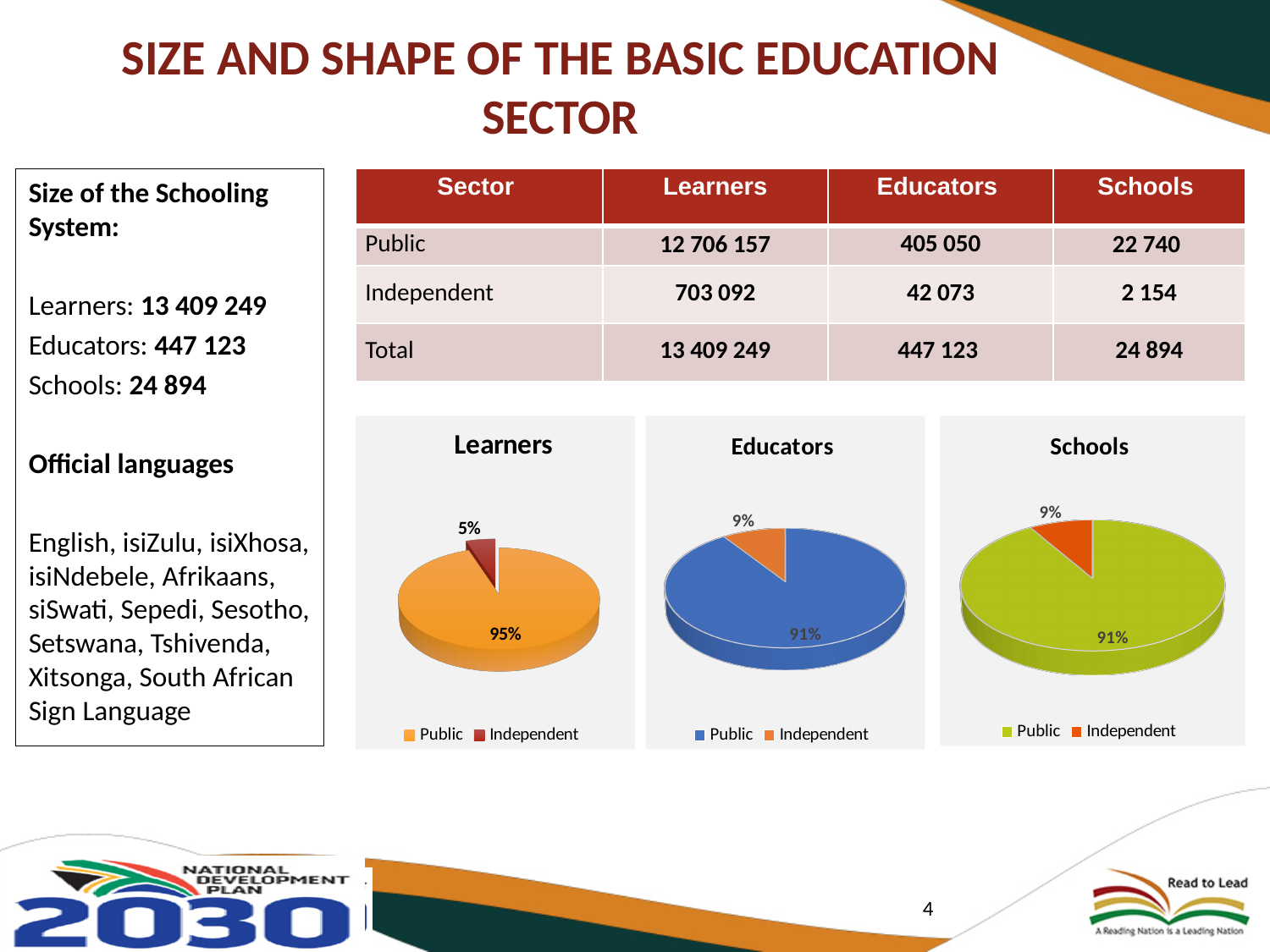
In the Schools chart, what is the value shown for Independent? 9% In the Educators chart, what share of the pie is Independent? 9% In the Schools chart, which is larger, Public or Independent? Public In the Educators chart, what is the value shown for Public? 91% How many entries does the legend of the Schools chart list? 2 In the Schools chart, what share of the pie is Public? 91% In the Learners chart, what share of the pie is Independent? 5% What kind of chart is the Educators chart? Pie chart In the Educators chart, which slice is the smallest? Independent In the Learners chart, what is the difference between the Public and Independent shares? 90% In the Learners chart, which slice is the largest? Public